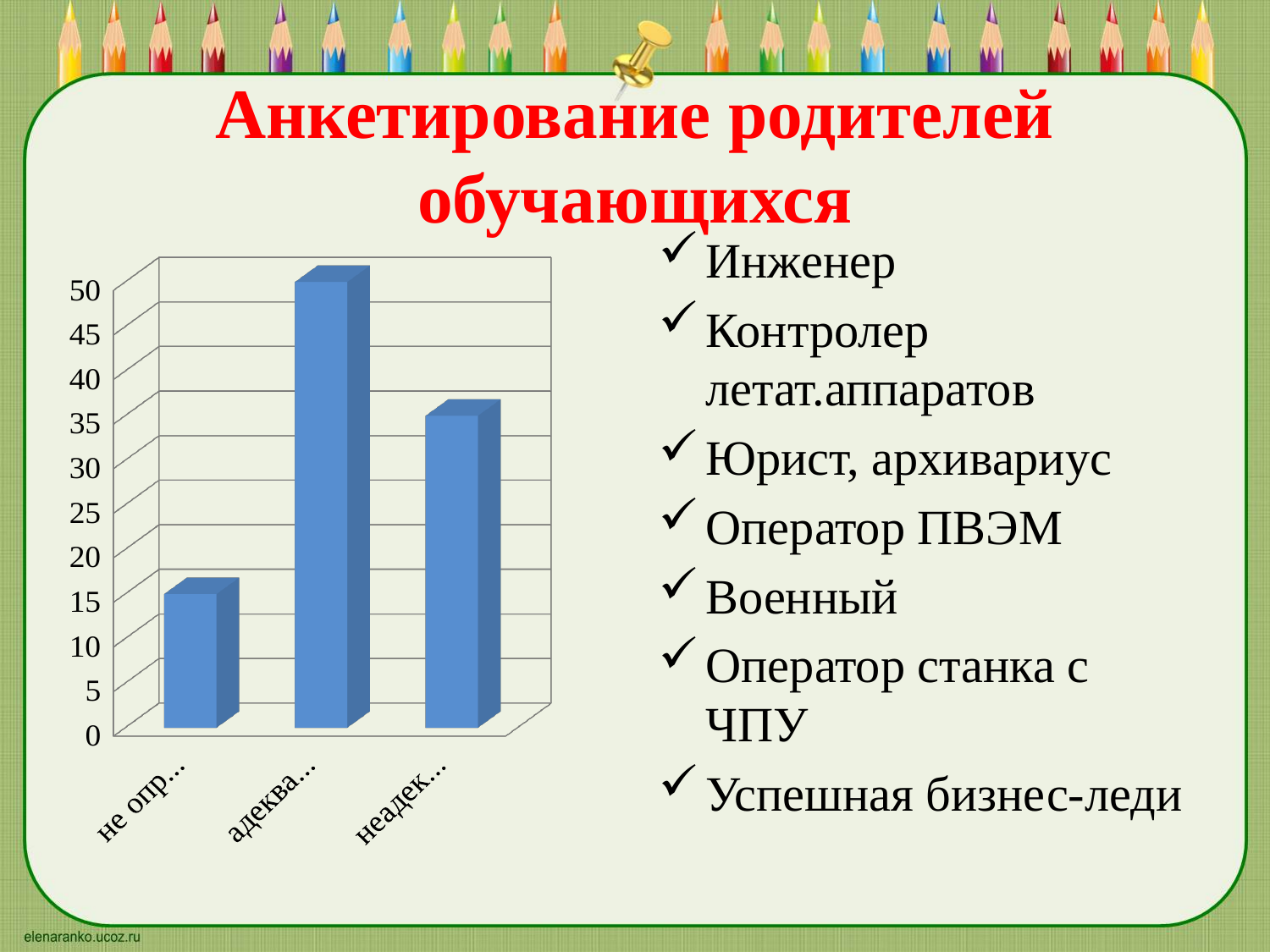
Which category has the highest bar in the chart? адеква... (the middle bar) What is the highest value shown on the vertical axis of the chart? 50 Which category has the lowest bar in the chart? не опр... (the first bar) What is the value of the middle bar (адеква...)? 50 How many bars (categories) does the chart show? 3 What is the difference between the middle bar (адеква...) and the first bar (не опр...)? 35 Is the value for the first bar (не опр...) greater or less than 20? less What kind of chart is shown on the slide? bar chart What is the value of the third bar (неадек...)? 35 Which is larger: the value for адеква... or the value for неадек...? адеква... What is the value of the first bar (не опр...)? 15 Is the value for the third bar (неадек...) greater or less than 30? greater